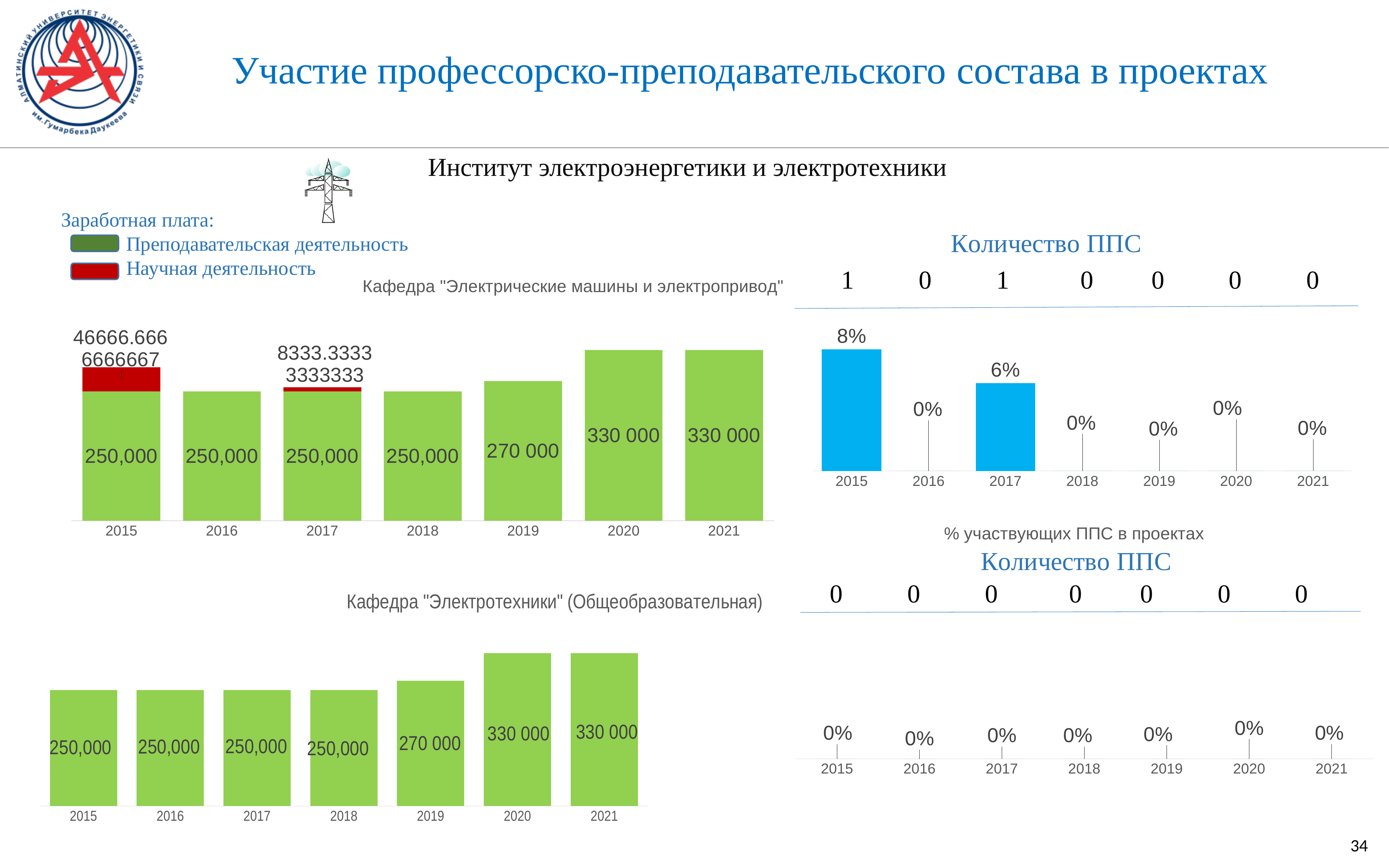
In the chart titled Кафедра "Электрические машины и электропривод", how many years are shown on the x axis? 7 In the chart titled Кафедра "Электротехники" (Общеобразовательная), do the values rise or fall from 2015 to 2021? rise In the chart titled Кафедра "Электрические машины и электропривод", what is the teaching-activity (green) value for 2019? 270 000 In the chart titled Кафедра "Электрические машины и электропривод", what is the teaching-activity (green) value for 2021? 330 000 In the upper-right chart (% участвующих ППС в проектах), what is the value for 2015? 8% What kind of chart is the one titled Кафедра "Электротехники" (Общеобразовательная)? bar chart In the upper-right chart (% участвующих ППС в проектах), which is larger, the value for 2015 or the value for 2017? 2015 In the upper-right chart (% участвующих ППС в проектах), which year has the highest value? 2015 In the lower-right chart (% участвующих ППС в проектах), what is the value for 2020? 0% In the chart titled Кафедра "Электротехники" (Общеобразовательная), what is the difference between the 2020 value and the 2019 value? 60 000 In the chart titled Кафедра "Электрические машины и электропривод", which years have a red (Научная деятельность) segment? 2015 and 2017 In the chart titled Кафедра "Электротехники" (Общеобразовательная), what is the value for 2018? 250,000